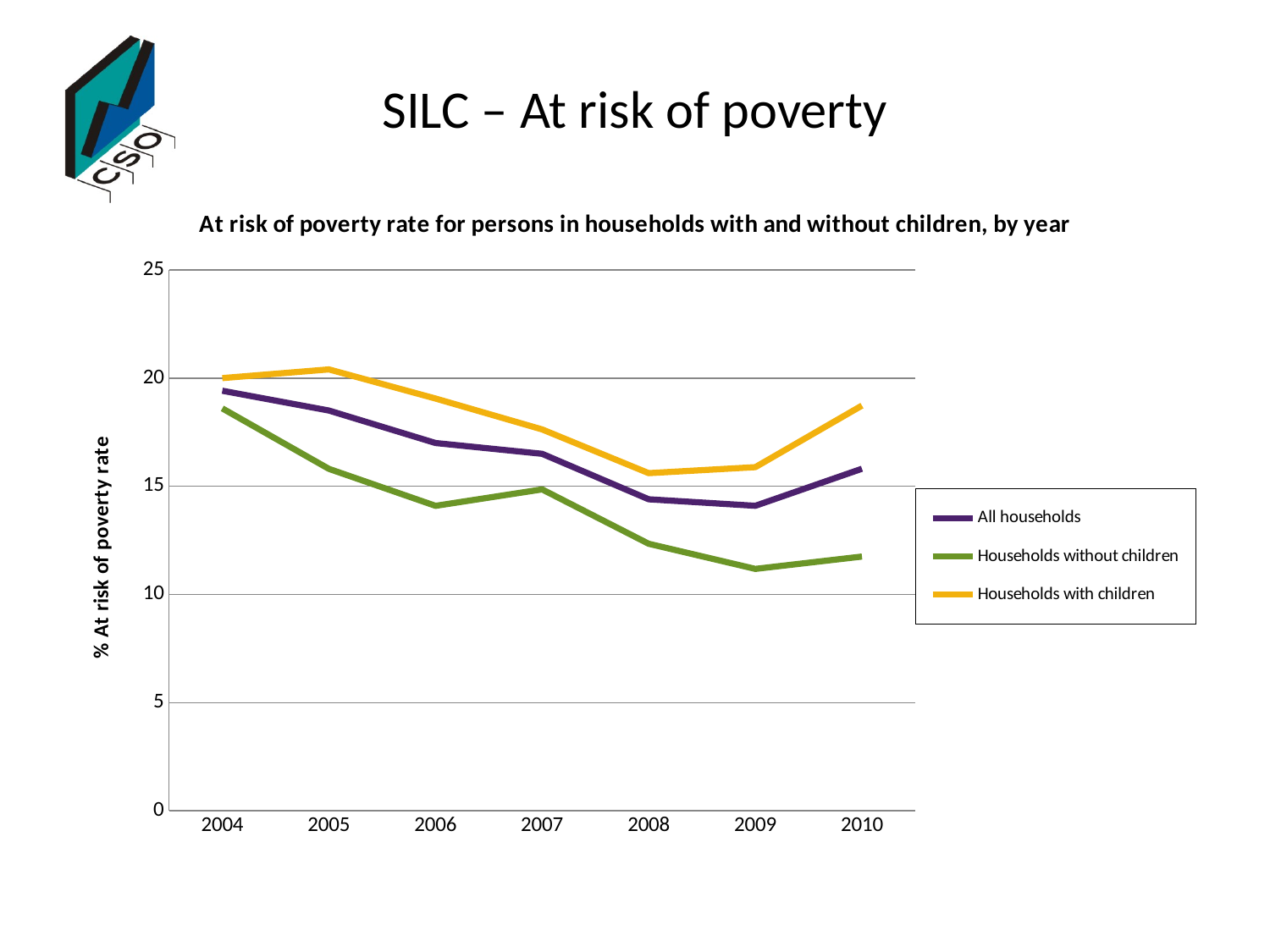
In which year is the value for Households without children lowest? 2009 Is the value for All households in 2004 greater or less than 20? less Is the value for Households without children in 2004 greater or less than 15? greater What is the title of the chart? At risk of poverty rate for persons in households with and without children, by year What is the label on the vertical axis? % At risk of poverty rate What kind of chart is shown on the slide? line chart How many series does the legend list? 3 In 2010, which is larger: the value for Households with children or Households without children? Households with children In which year is the value for Households without children highest? 2004 Is the value for Households without children in 2009 greater or less than 15? less How many years are shown on the x axis? 7